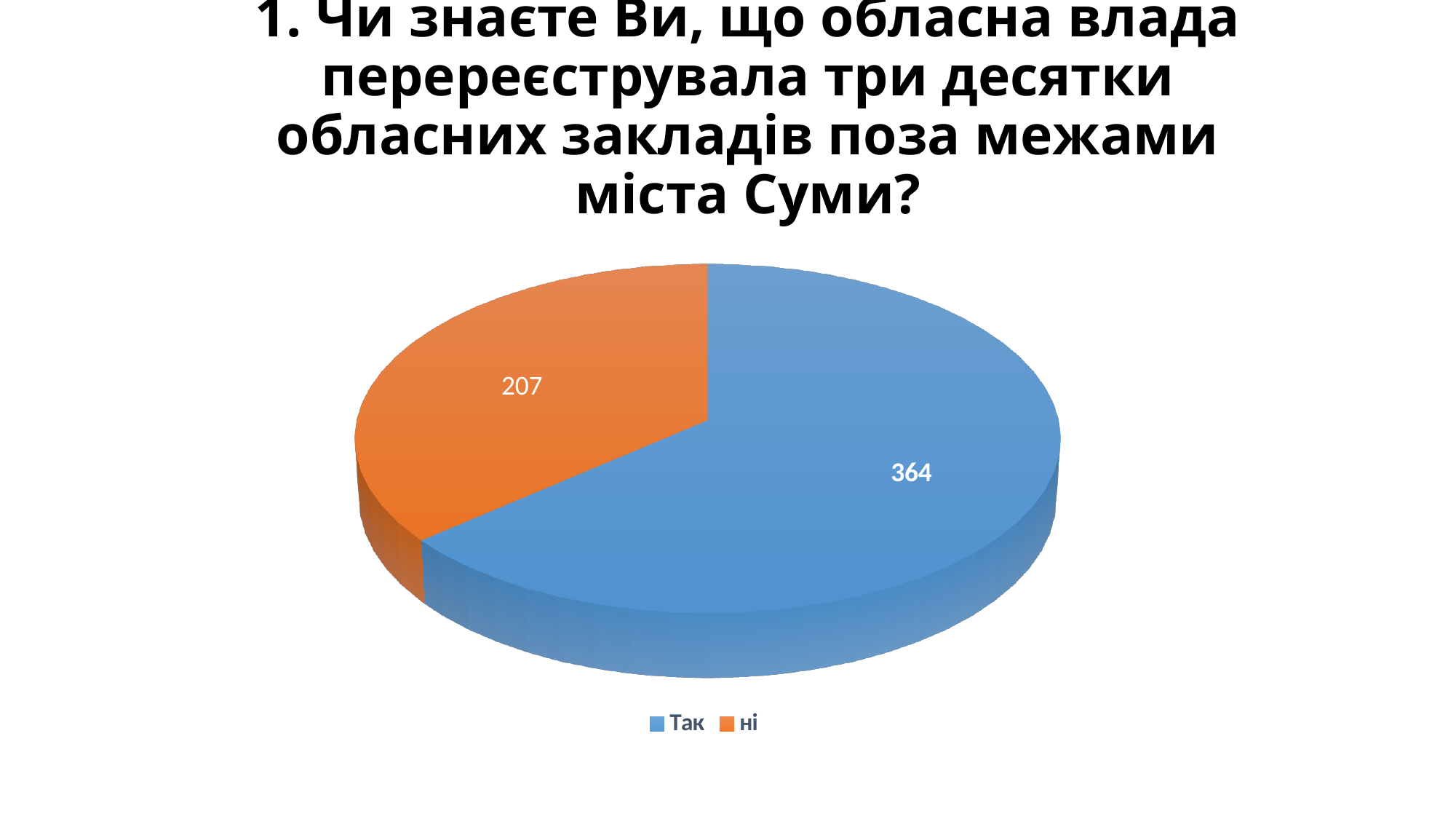
What is the total of the two values shown in the pie chart? 571 What is the difference between the "Так" and "ні" values in the pie chart? 157 What colour is the "Так" slice in the pie chart? Blue How many entries does the legend of the chart list? 2 Which slice of the pie chart is the largest? Так What kind of chart is shown on the slide? Pie chart What colour is the "ні" slice in the pie chart? Orange Which slice of the pie chart is the smallest? ні What value is shown for the "Так" slice of the pie chart? 364 How many slices does the pie chart have? 2 Which is larger in the pie chart, "Так" or "ні"? Так What value is shown for the "ні" slice of the pie chart? 207